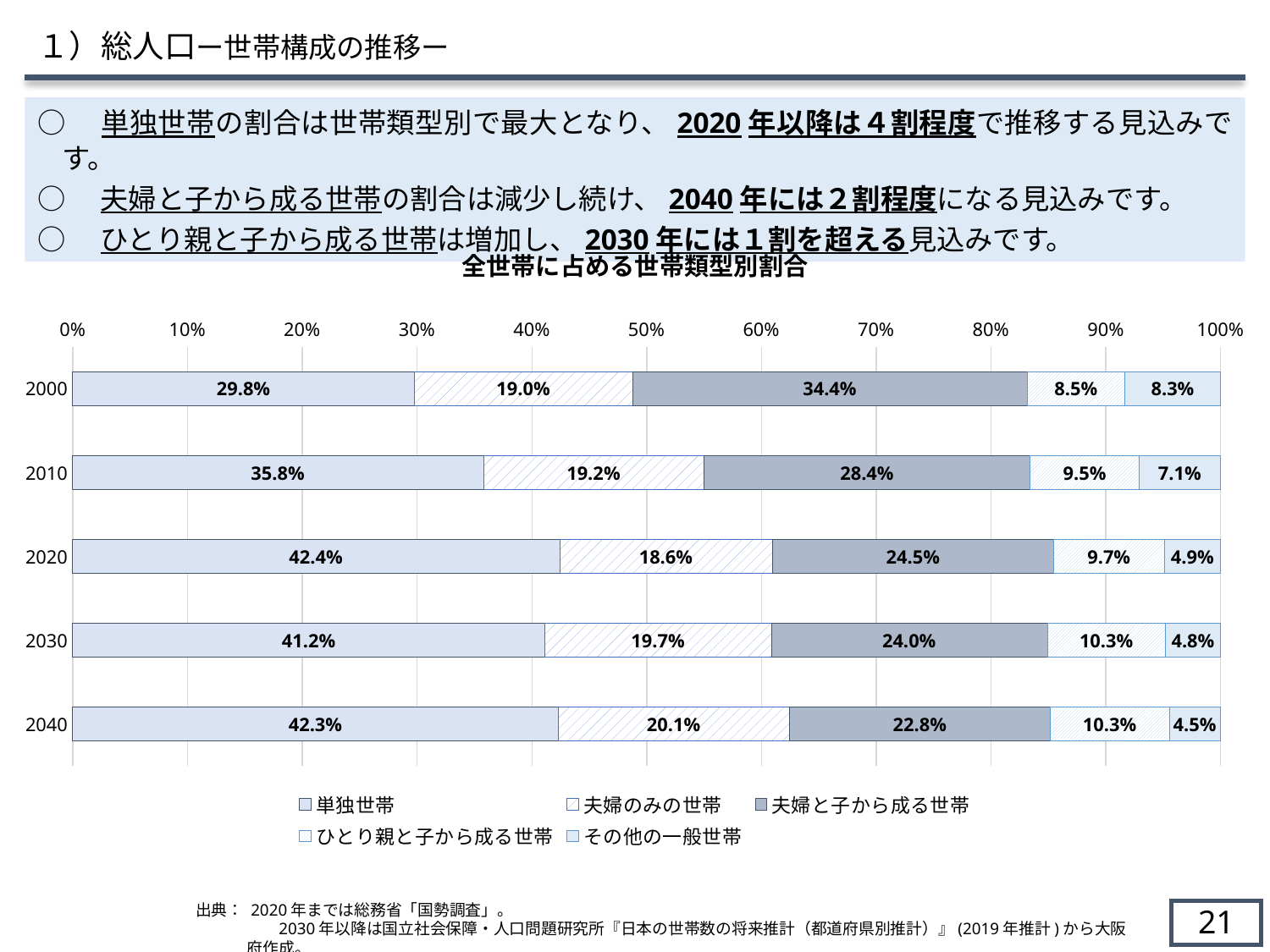
How many series does the legend list? 5 How many years (categories) are plotted on the chart? 5 What is the share of 夫婦と子から成る世帯 in 2000? 34.4% Does the share of その他の一般世帯 rise or fall from 2000 to 2040? Fall What is the share of ひとり親と子から成る世帯 in 2040? 10.3% What is the title of the chart? 全世帯に占める世帯類型別割合 What type of chart is shown on the slide? Stacked bar chart In which year is the share of 夫婦と子から成る世帯 the highest? 2000 Which is larger in 2010: the share of 夫婦のみの世帯 or the share of 夫婦と子から成る世帯? 夫婦と子から成る世帯 In which year is the share of 単独世帯 the lowest? 2000 What is the share of 単独世帯 in 2020? 42.4% What is the difference between the share of 単独世帯 in 2040 and in 2000? 12.5%